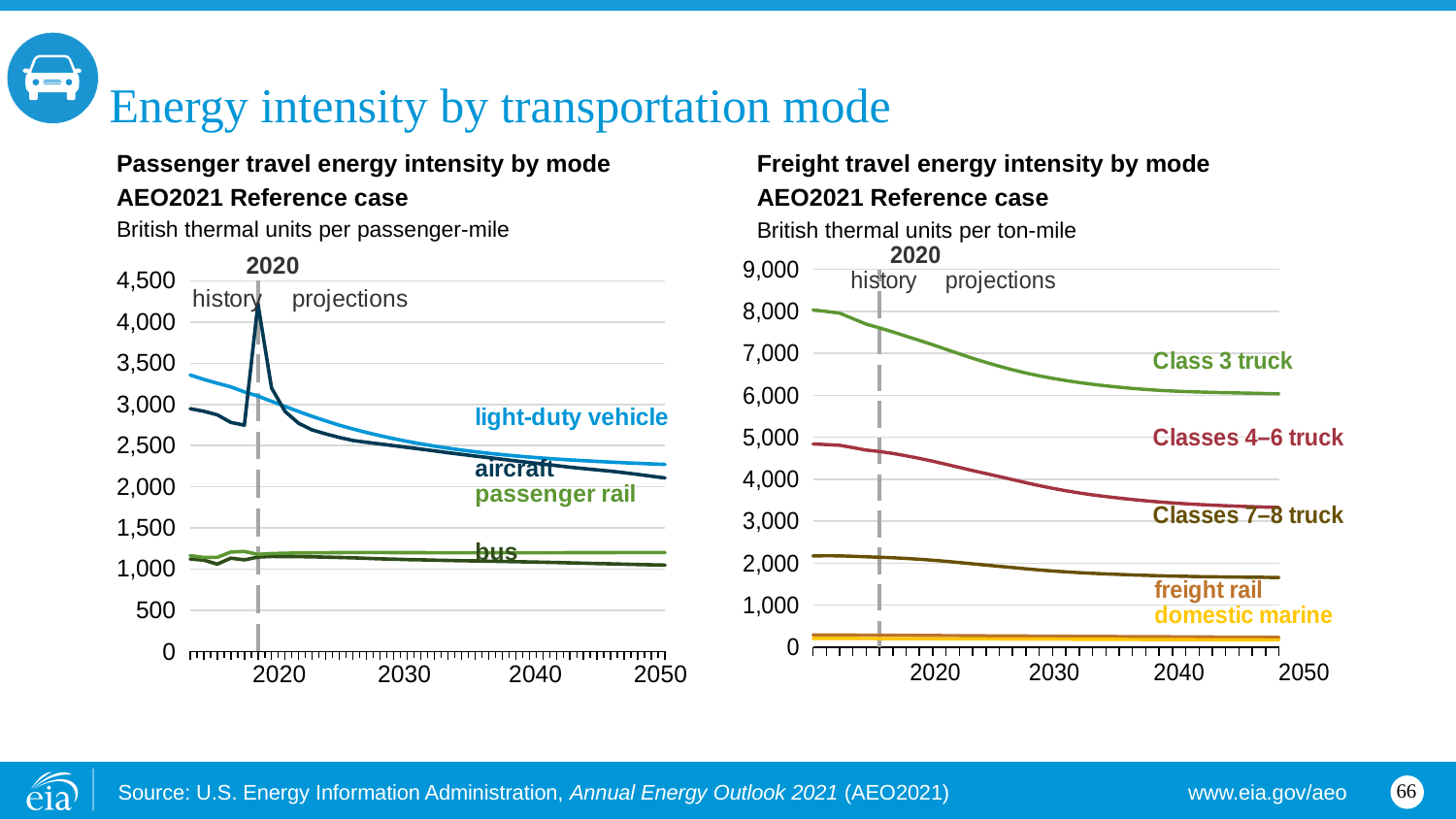
In the 'Freight travel energy intensity by mode' chart, is the value for Classes 7–8 truck in 2050 greater or less than 2,000? less In the 'Freight travel energy intensity by mode' chart, which mode has the lowest energy intensity? domestic marine What kind of chart is the 'Passenger travel energy intensity by mode' chart? line chart How many modes are plotted in the 'Passenger travel energy intensity by mode' chart? 4 In the 'Passenger travel energy intensity by mode' chart, is the value for light-duty vehicle in 2050 greater or less than 2,500? less In the 'Passenger travel energy intensity by mode' chart, is the peak value for aircraft greater or less than 4,000? greater In the 'Freight travel energy intensity by mode' chart, does the Class 3 truck line rise or fall from 2020 to 2050? fall In the 'Freight travel energy intensity by mode' chart, which is larger in 2050: Class 3 truck or Classes 7–8 truck? Class 3 truck How many modes are plotted in the 'Freight travel energy intensity by mode' chart? 5 In the 'Freight travel energy intensity by mode' chart, which mode has the highest energy intensity throughout the period? Class 3 truck What unit is used on the 'Freight travel energy intensity by mode' chart? British thermal units per ton-mile